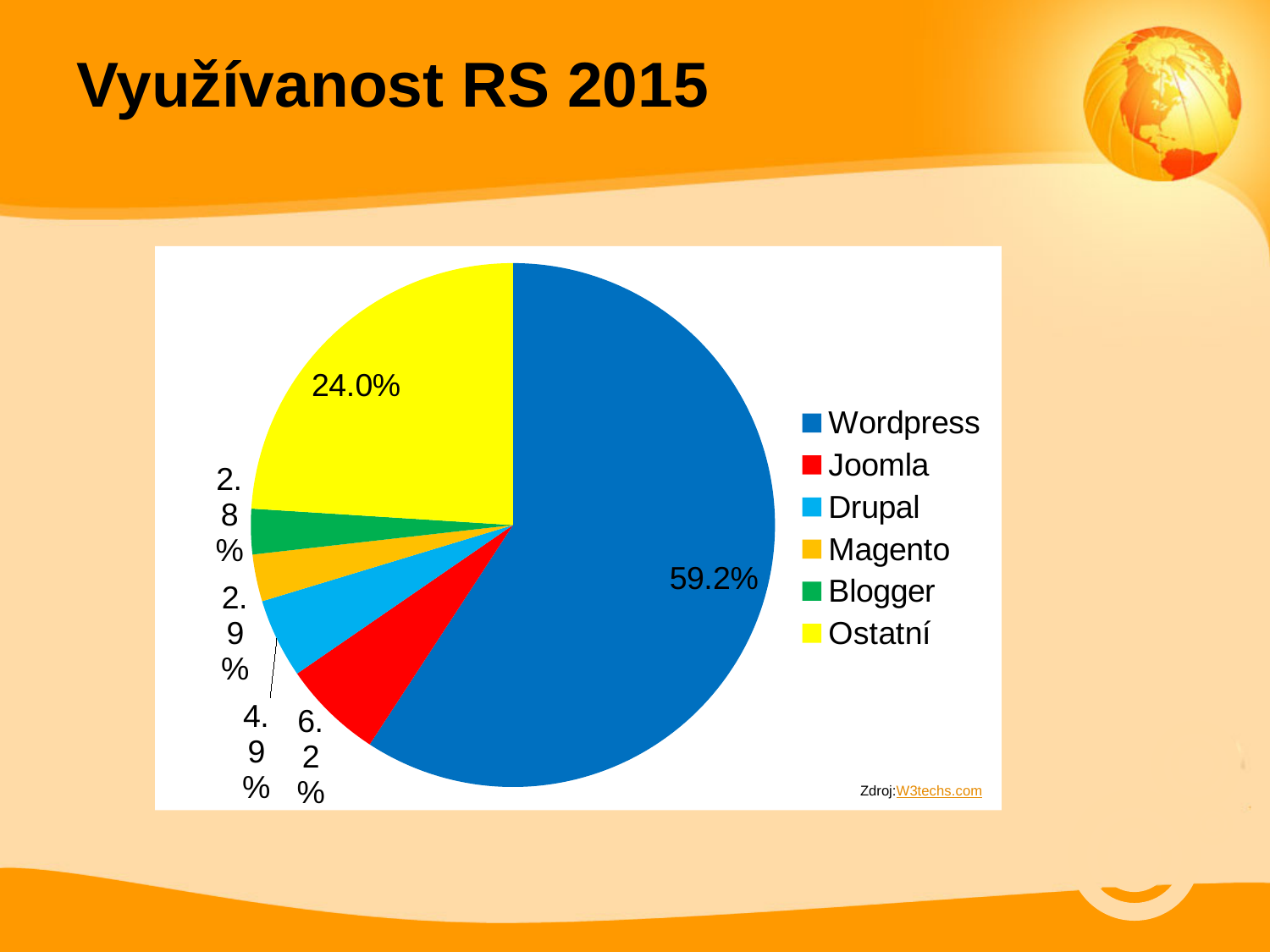
Which category has the largest slice of the pie? Wordpress What share of the pie does Ostatní have? 24.0% What kind of chart is shown on the slide? pie chart What is the value shown for Joomla? 6.2% Which category has the smallest slice of the pie? Blogger What is the difference between the Wordpress share and the Ostatní share? 35.2% What share of the pie does Wordpress have? 59.2% What is the title of the slide containing the chart? Využívanost RS 2015 How many slices does the pie chart have? 6 How many entries does the legend list? 6 Which is larger, the Joomla slice or the Drupal slice? Joomla What is the value shown for Drupal? 4.9%